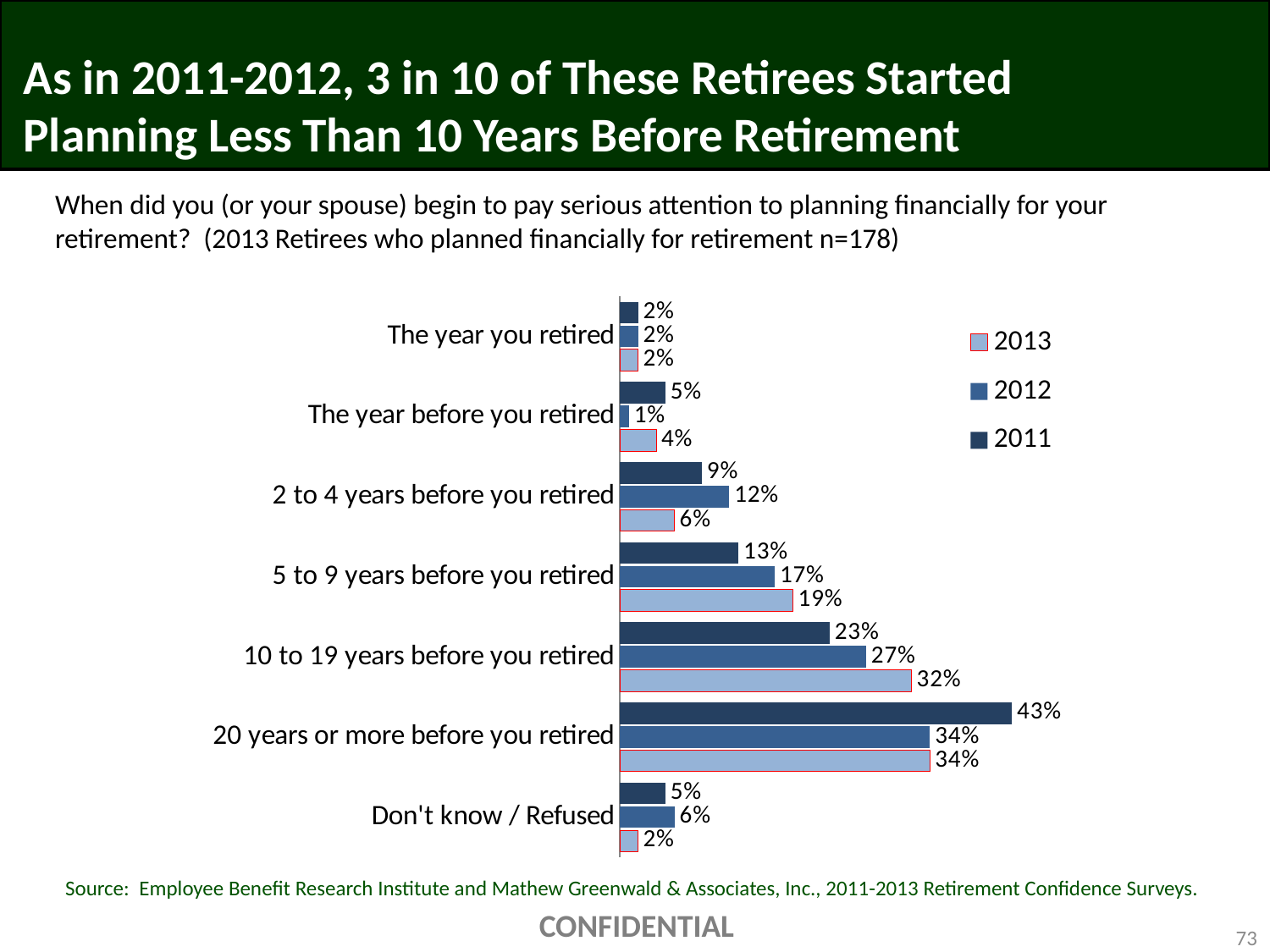
For '2 to 4 years before you retired', which year has the larger value, 2012 or 2013? 2012 What is the difference between the 2012 and 2013 values for 'Don't know / Refused'? 4% Which category has the lowest value for the 2012 series? The year before you retired What is the difference between the 2011 and 2013 values for '20 years or more before you retired'? 9% Which category has the highest value for the 2013 series? 20 years or more before you retired What is the 2012 value for 'The year before you retired'? 1% How many categories are shown on the chart? 7 For '5 to 9 years before you retired', which year has the larger value, 2011 or 2013? 2013 How many series does the legend list? 3 What percentage of 2013 retirees began planning 10 to 19 years before they retired? 32% What is the 2011 value for '20 years or more before you retired'? 43% What kind of chart is shown on the slide? Bar chart